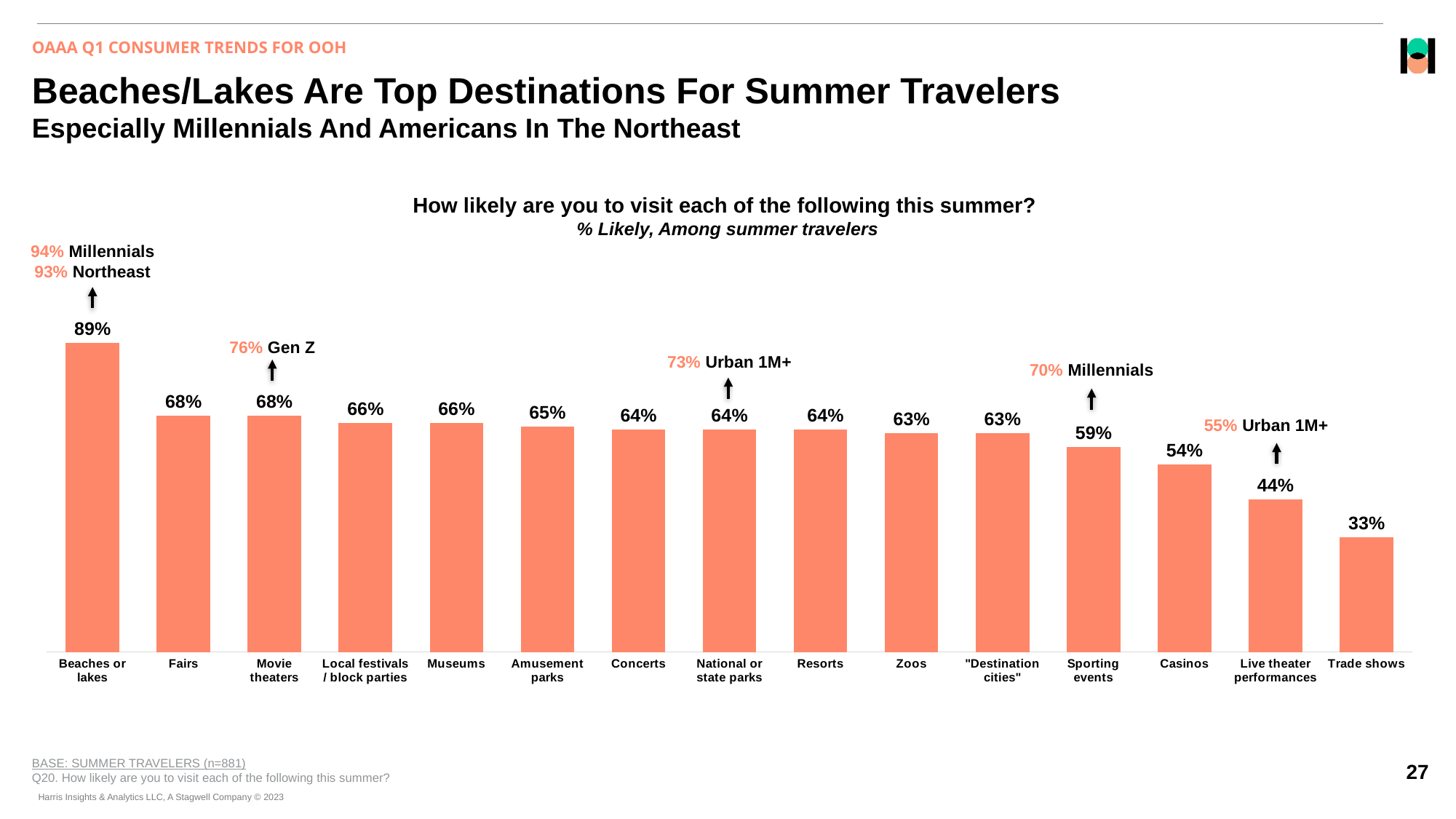
What percentage of summer travelers say they are likely to visit beaches or lakes this summer? 89% Which has a higher value, Casinos or Zoos? Zoos According to the annotation above the Movie theaters bar, what percentage of Gen Z are likely to visit movie theaters? 76% What is the difference in percentage points between Beaches or lakes and Fairs? 21 How many categories are shown in the chart? 15 Do the values generally rise or fall moving from left to right across the chart? Fall Which category has the lowest percentage of summer travelers likely to visit? Trade shows What percentage is shown for Casinos? 54% What is the difference in percentage points between Sporting events and Live theater performances? 15 What type of chart is shown on the slide? Bar chart What is the value shown for Trade shows? 33% Which category has the highest percentage of summer travelers likely to visit? Beaches or lakes